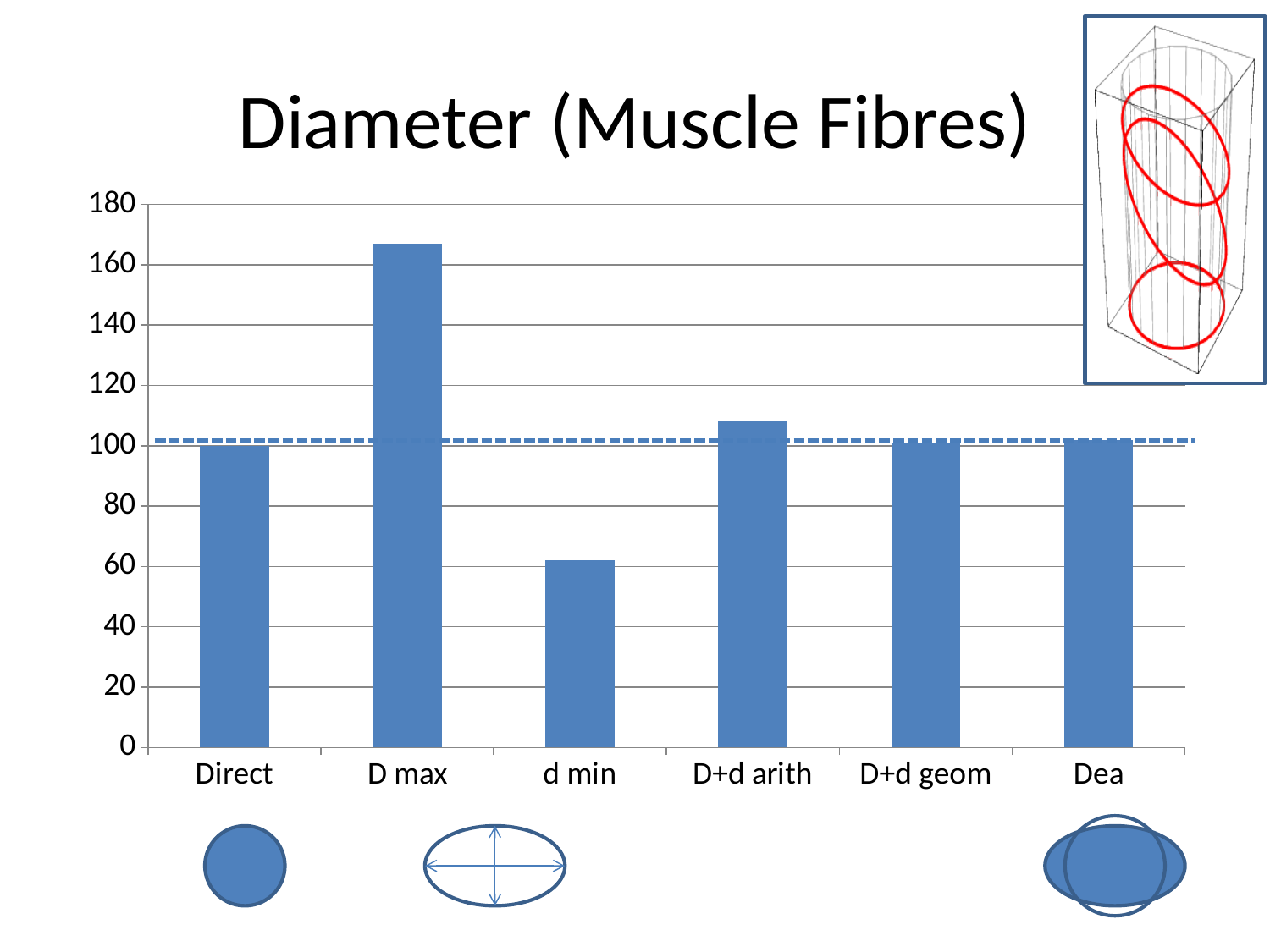
Which is larger, the value for D max or the value for D+d arith? D max Which is larger, the value for d min or the value for Direct? Direct Is the value for d min greater or less than 80? less Is the value for D max greater or less than 160? greater Which category has the lowest bar? d min What kind of chart is shown on the slide? bar chart Which category has the highest bar? D max What is the highest value shown on the y axis of the chart? 180 Is the value for D+d arith greater or less than 100? greater What is the title of the chart? Diameter (Muscle Fibres) How many categories are shown on the x axis of the chart? 6